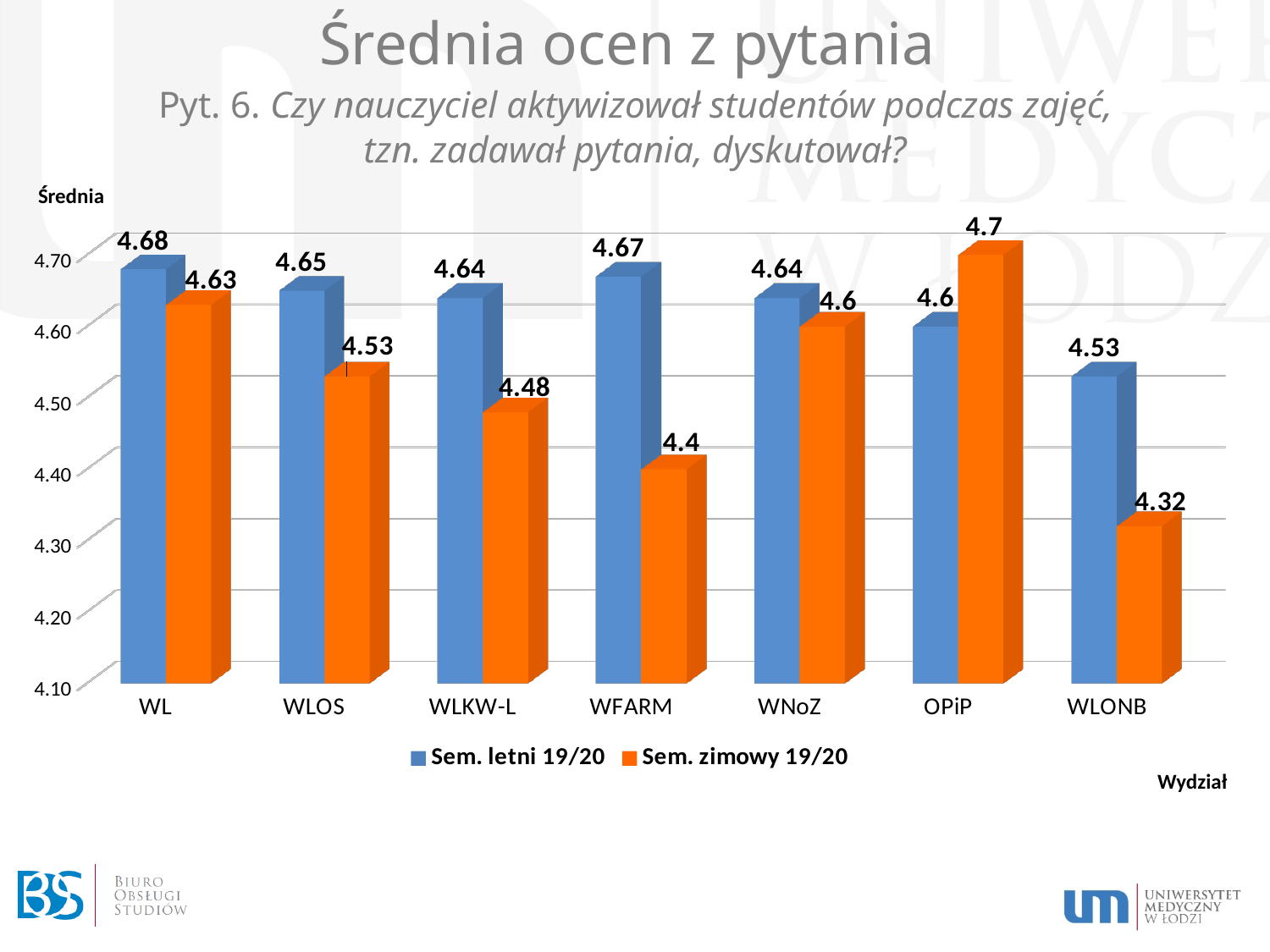
Which category has the lowest value in the Sem. zimowy 19/20 series? WLONB What is the value for WLONB in the Sem. letni 19/20 series? 4.53 What kind of chart is shown on the slide? Bar chart What is the value for WFARM in the Sem. zimowy 19/20 series? 4.4 How many categories (faculties) are shown on the x axis? 7 What is the difference between the Sem. letni 19/20 and Sem. zimowy 19/20 values for WFARM? 0.27 Which category has the lowest value in the Sem. letni 19/20 series? WLONB How many series does the legend list? 2 Which colour represents the Sem. zimowy 19/20 series? Orange For OPiP, which series has the larger value: Sem. letni 19/20 or Sem. zimowy 19/20? Sem. zimowy 19/20 What is the value for OPiP in the Sem. zimowy 19/20 series? 4.7 Which category has the highest value in the Sem. zimowy 19/20 series? OPiP